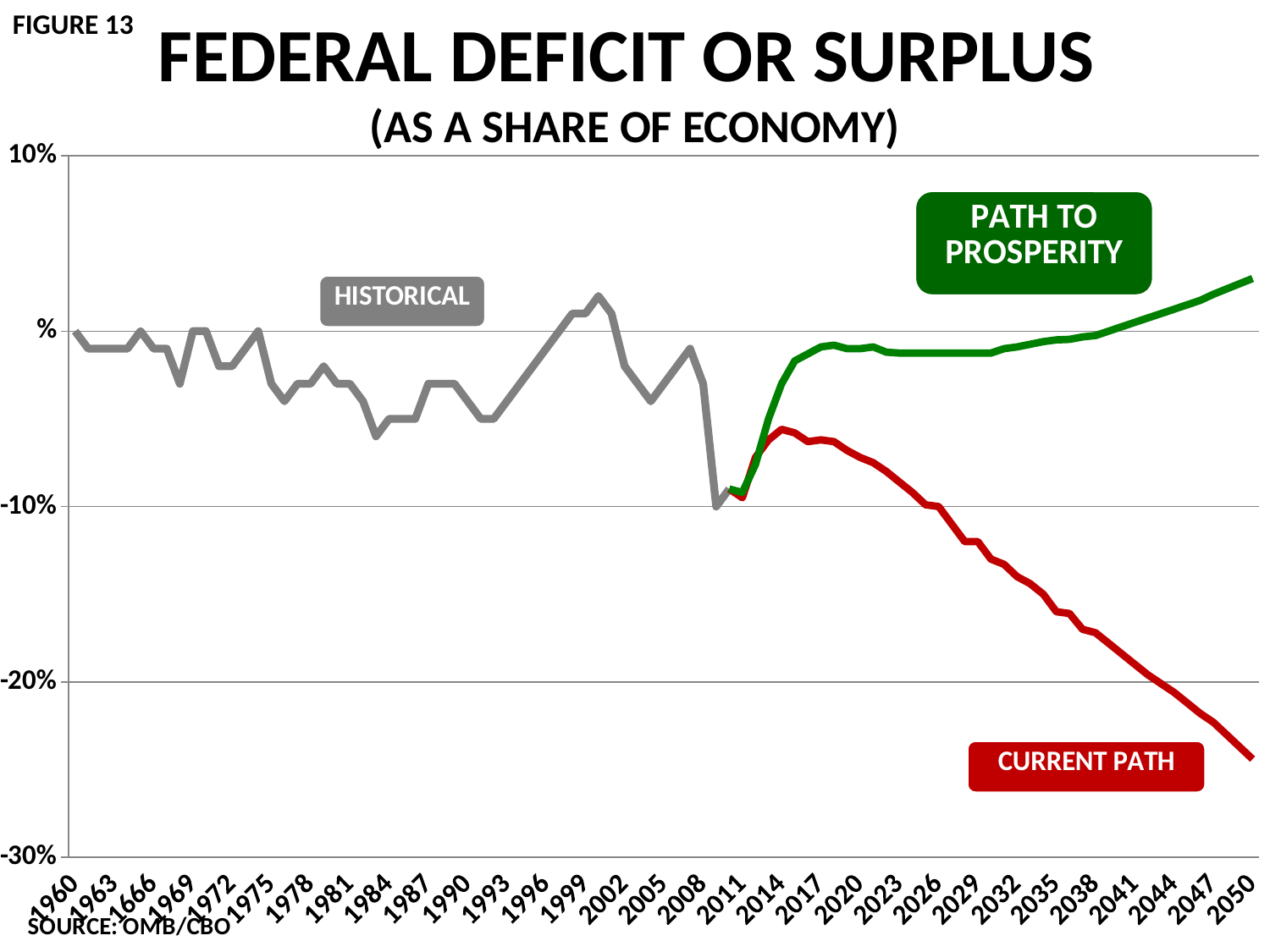
What kind of chart is shown on the slide? line chart How many series are labelled on the chart? 3 In 2050, which series has the higher value, Path to Prosperity or Current Path? Path to Prosperity Is the value for Current Path in 2035 greater or less than -10%? less What colour is the Current Path line? red Is the value for Current Path in 2050 greater or less than -20%? less Is the value for Path to Prosperity in 2050 greater or less than 0%? greater Does the Path to Prosperity line rise or fall from 2011 to 2050? rise What is the title of the chart? FEDERAL DEFICIT OR SURPLUS (AS A SHARE OF ECONOMY) Does the Current Path line rise or fall from 2014 to 2050? fall